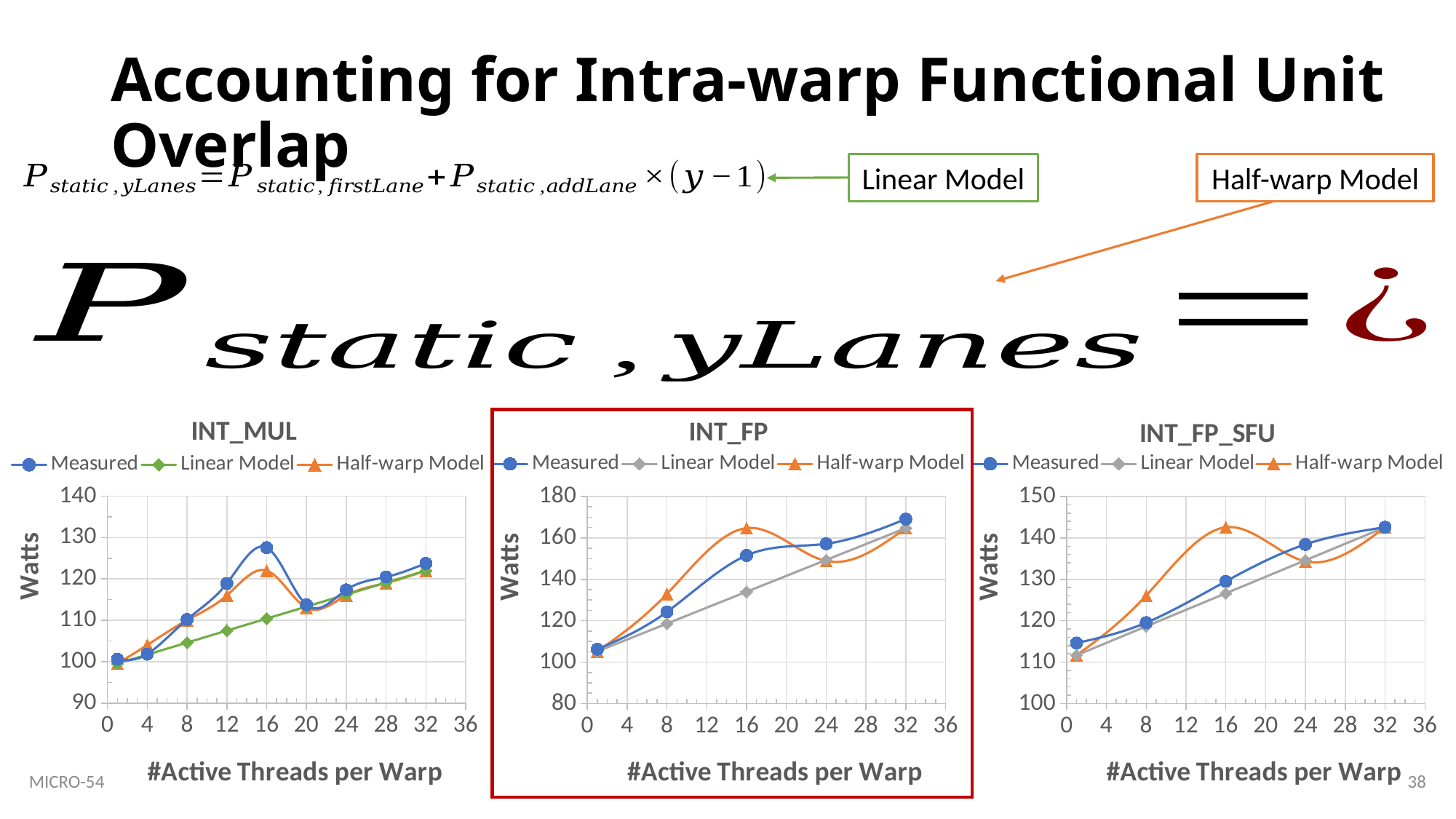
What is the y-axis label on the INT_MUL chart? Watts In the INT_FP chart, at 16 active threads, which is larger: the Half-warp Model or the Linear Model? Half-warp Model What are the three series named in the legend of the INT_FP_SFU chart? Measured, Linear Model, Half-warp Model How many data points does the Measured series have in the INT_FP chart? 5 In the INT_FP chart, at which number of active threads per warp does the Measured series reach its highest value? 32 In the INT_MUL chart, is the Measured value at 16 active threads greater or less than 120? greater What type of chart is the INT_MUL chart? line chart In the INT_FP chart, is the Half-warp Model value at 16 active threads greater or less than 160? greater In the INT_FP_SFU chart, is the Linear Model value at 16 active threads greater or less than 130? less In the INT_MUL chart, at which number of active threads per warp does the Measured series reach its highest value? 16 How many series does the legend of the INT_FP chart list? 3